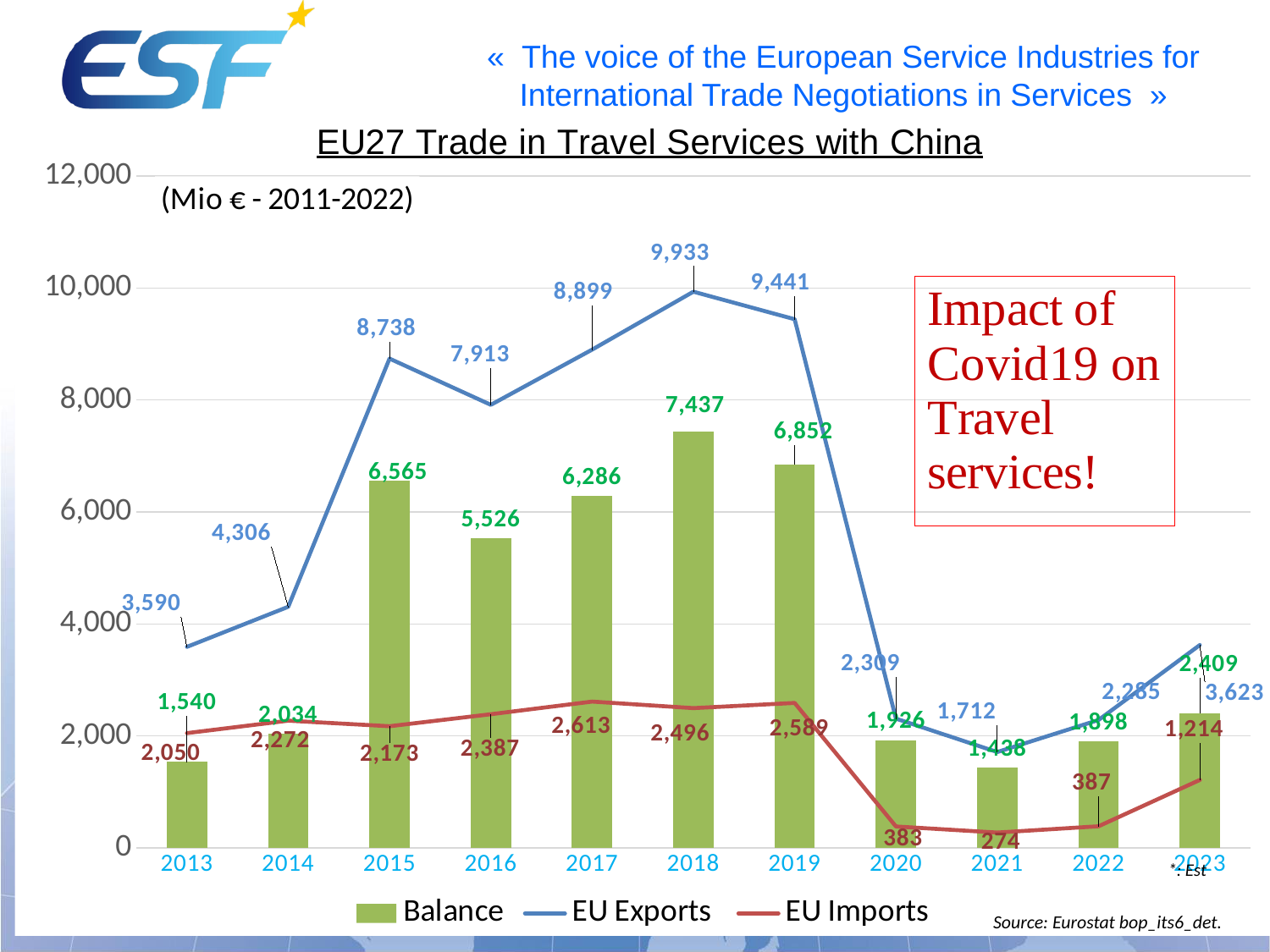
In which year is EU Imports lowest? 2021 What is the title of the chart? EU27 Trade in Travel Services with China How many series does the legend list? 3 How do EU Exports change from 2019 to 2020? They fall What is the EU Imports value for 2021? 274 Is the EU Exports value for 2015 greater or less than 8,000? greater What is the EU Exports value for 2018? 9,933 What is the Balance value for 2015? 6,565 How many years are shown on the x axis? 11 In which year is EU Exports highest? 2018 What is the difference between EU Exports and EU Imports in 2017? 6,286 Which is larger, the Balance in 2018 or the Balance in 2019? 2018